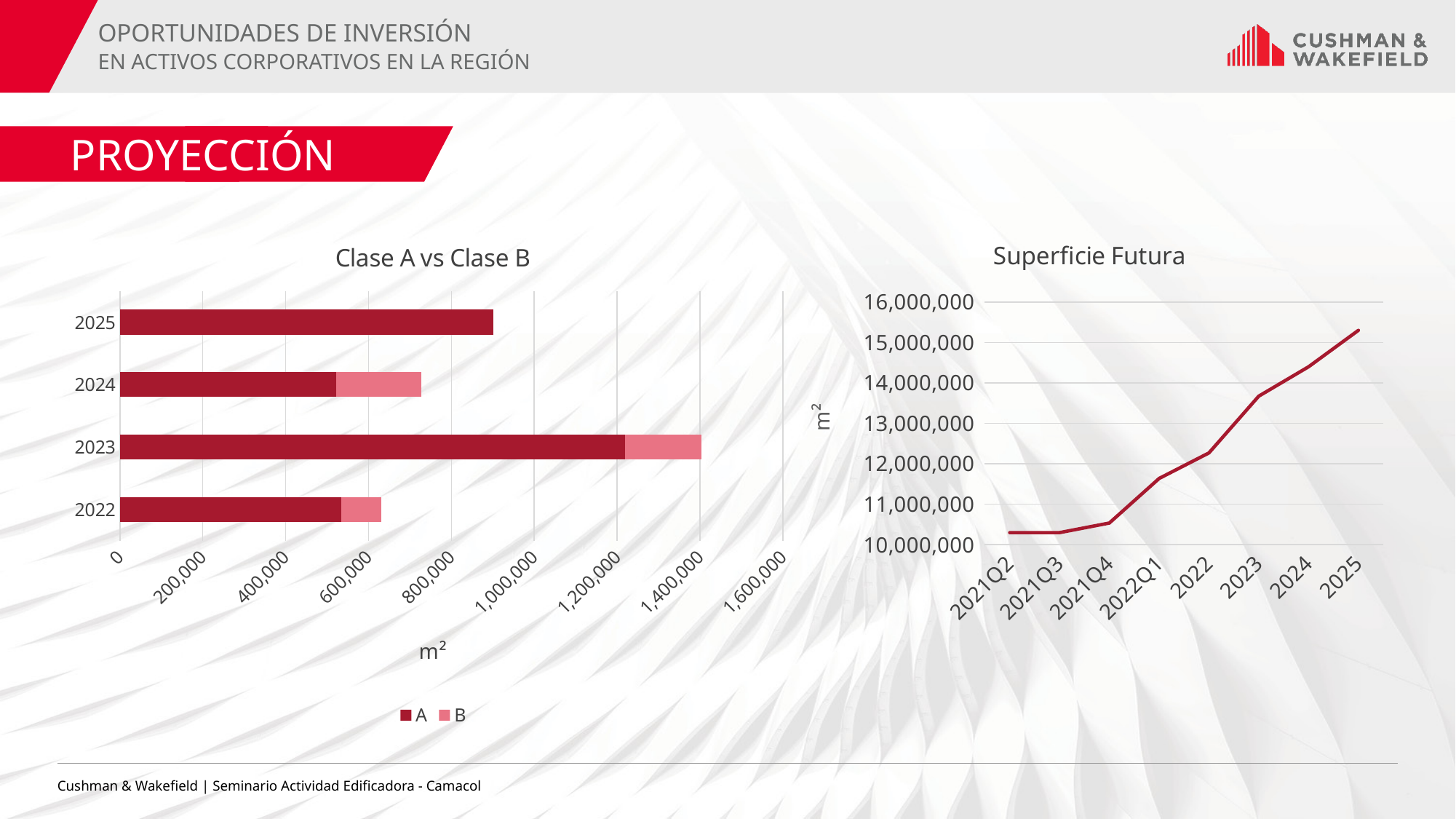
In the "Superficie Futura" chart, do the values rise or fall from 2021Q2 to 2025? rise In the "Clase A vs Clase B" chart, which year has the longest total bar? 2023 What kind of chart is the "Superficie Futura" chart? line chart What kind of chart is the "Clase A vs Clase B" chart? bar chart In the "Superficie Futura" chart, is the value for 2021Q2 greater or less than 11,000,000? less In the "Clase A vs Clase B" chart, how many series does the legend list? 2 In the "Clase A vs Clase B" chart, is the value for series A in 2025 greater or less than 800,000? greater In the "Clase A vs Clase B" chart, is the value for series A in 2023 greater or less than 1,000,000? greater In the "Clase A vs Clase B" chart, how many years are shown on the vertical axis? 4 In the "Superficie Futura" chart, how many points are plotted along the x axis? 8 In the "Clase A vs Clase B" chart, which is larger: series A in 2023 or series A in 2025? series A in 2023 What is the label on the vertical axis of the "Superficie Futura" chart? m²